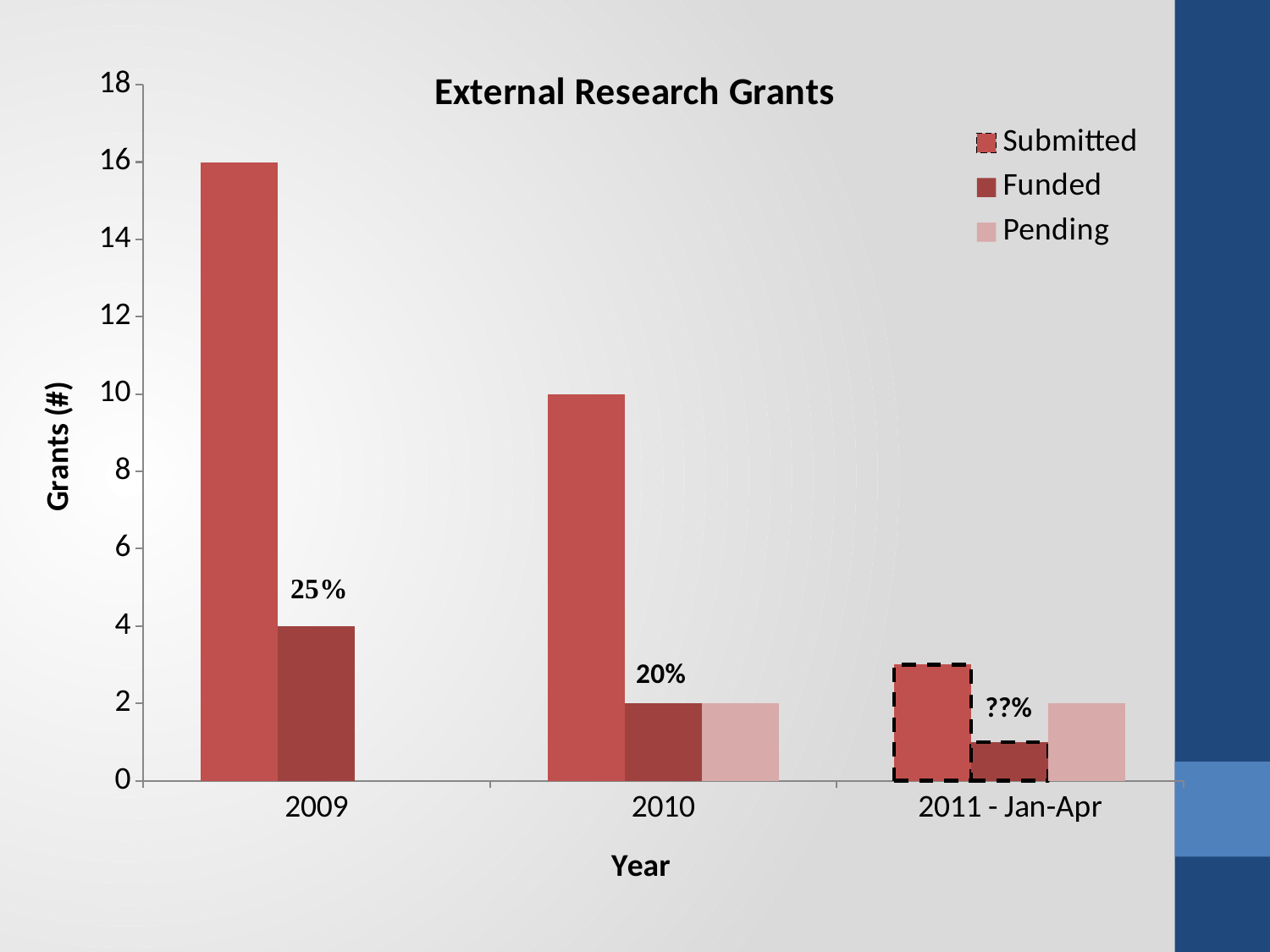
How many grants were Submitted in 2010? 10 Do the Submitted grant counts rise or fall from 2009 to 2011 - Jan-Apr? fall How many series does the legend of the External Research Grants chart list? 3 What kind of chart is shown on the slide? bar chart In which year was the number of Submitted grants highest? 2009 Is the number of Submitted grants for 2011 - Jan-Apr greater or less than 4? less How many grants were Submitted in 2009? 16 How many grants were Pending in 2010? 2 How many year categories are shown on the x axis of the chart? 3 What is the difference between Submitted and Funded grants in 2009? 12 What percentage label is printed above the Funded bar for 2010? 20% How many grants were Funded in 2009? 4